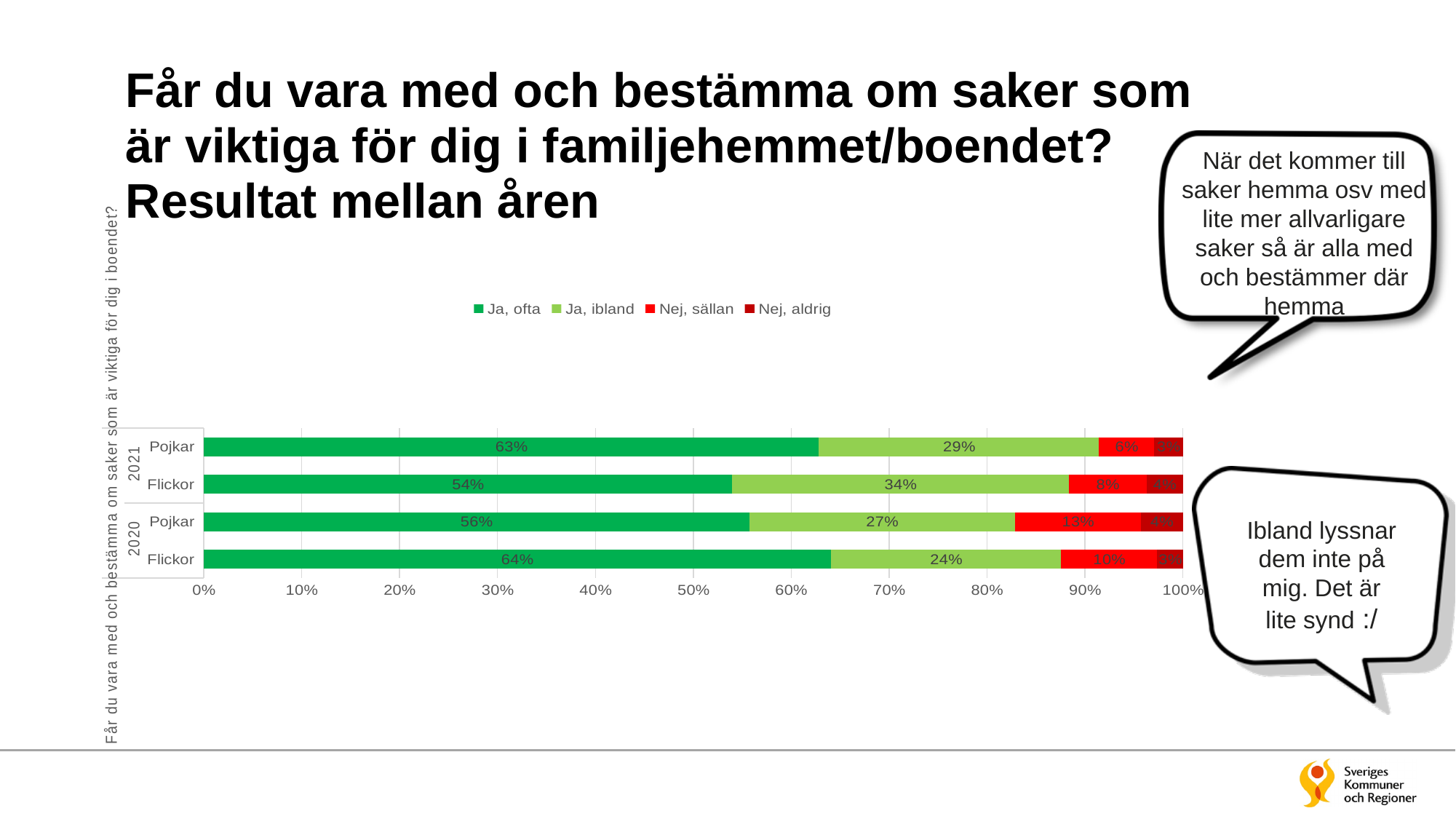
What percentage of Flickor in 2020 answered "Ja, ofta"? 64% Which group has the larger "Nej, sällan" share in 2020, Pojkar or Flickor? Pojkar What kind of chart is shown on the slide? Stacked bar chart How many bars are shown in the chart? 4 Which legend entry is shown in bright red? Nej, sällan Which group has the lowest share of "Ja, ofta" answers? Flickor 2021 Which group has the highest share of "Ja, ofta" answers? Flickor 2020 What percentage of Flickor in 2021 answered "Ja, ibland"? 34% What percentage of Pojkar in 2020 answered "Nej, sällan"? 13% How many series does the legend list? 4 How many percentage points higher is the "Ja, ibland" share for Flickor 2021 than for Pojkar 2020? 7 percentage points What percentage of Pojkar in 2021 answered "Ja, ofta"? 63%